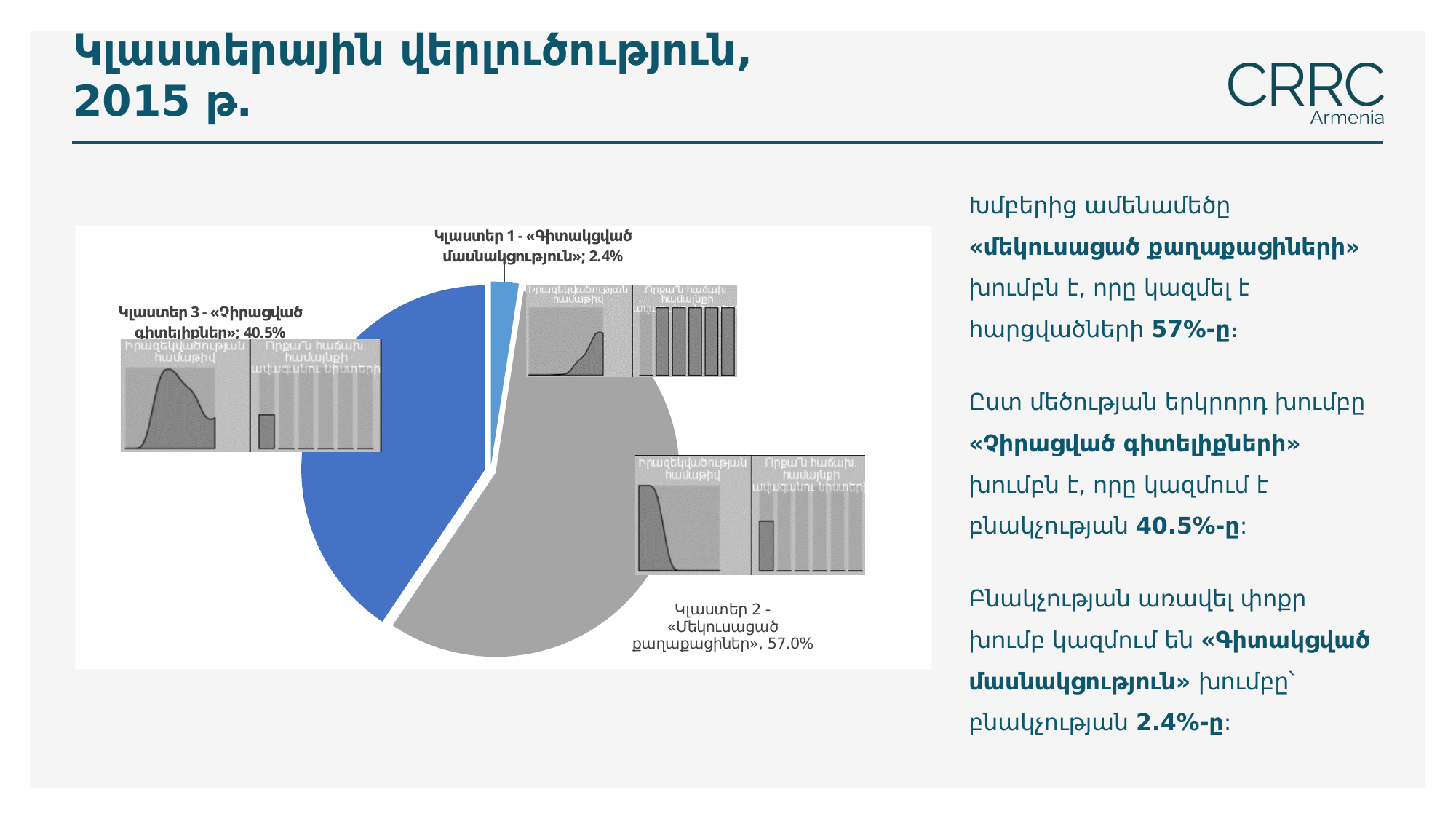
Which is larger, the share of Cluster 3 or the share of Cluster 1? Cluster 3 What is the difference in percentage points between Cluster 2 (57.0%) and Cluster 3 (40.5%)? 16.5 What is the title of the slide containing the pie chart? Կլաստերային վերլուծություն, 2015 թ. What is the difference in percentage points between Cluster 3 (40.5%) and Cluster 1 (2.4%)? 38.1 What kind of chart is shown on the slide? pie chart How many slices does the pie chart have? 3 Which cluster has the largest share of the pie? Կլաստեր 2 - «Մեկուսացած քաղաքացիներ» What colour is the slice for Cluster 2 (57.0%)? grey What is the value shown for Cluster 2 (Կլաստեր 2 - «Մեկուսացած քաղաքացիներ»)? 57.0% What is the value shown for Cluster 1 (Կլաստեր 1 - «Գիտակցված մասնակցություն»)? 2.4% What is the value shown for Cluster 3 (Կլաստեր 3 - «Չիրացված գիտելիքներ»)? 40.5% Which cluster has the smallest share of the pie? Կլաստեր 1 - «Գիտակցված մասնակցություն»